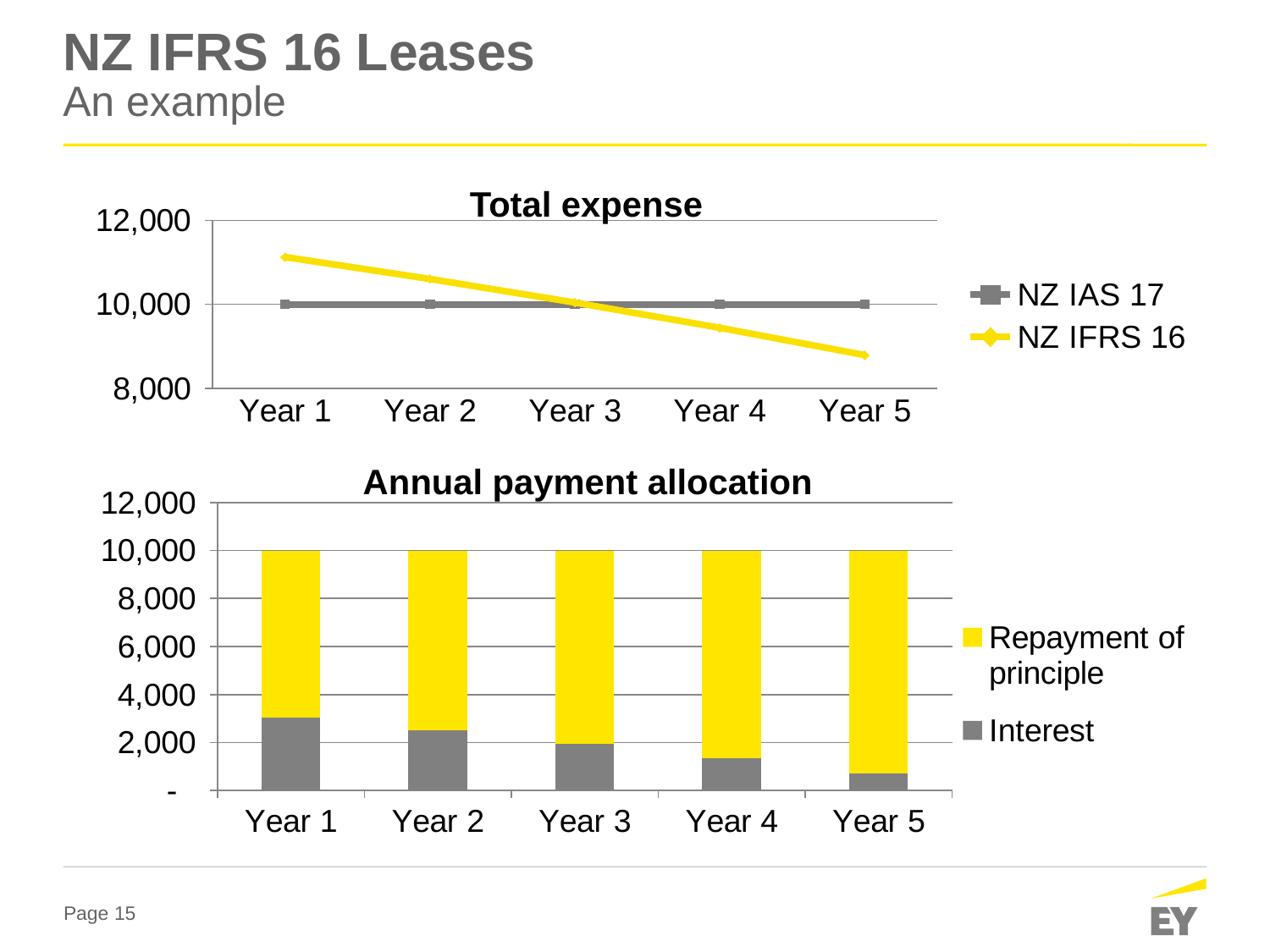
In the "Total expense" chart, is the NZ IFRS 16 value for Year 5 greater or less than 10,000? less What kind of chart is the "Annual payment allocation" chart? bar chart In the "Total expense" chart, does the NZ IFRS 16 line rise or fall from Year 1 to Year 5? fall In the "Annual payment allocation" chart, does the Interest portion rise or fall from Year 1 to Year 5? fall In the "Annual payment allocation" chart, which series is shown in yellow? Repayment of principle In the "Total expense" chart, is the NZ IFRS 16 value for Year 1 greater or less than 10,000? greater In the "Annual payment allocation" chart, how many categories are shown on the x axis? 5 In the "Annual payment allocation" chart, what is the total height of the Year 1 stacked bar? 10,000 In the "Total expense" chart, how many series does the legend list? 2 In the "Total expense" chart, which series has the higher value in Year 1, NZ IAS 17 or NZ IFRS 16? NZ IFRS 16 What kind of chart is the "Total expense" chart? line chart In the "Annual payment allocation" chart, which year has the largest Interest portion? Year 1